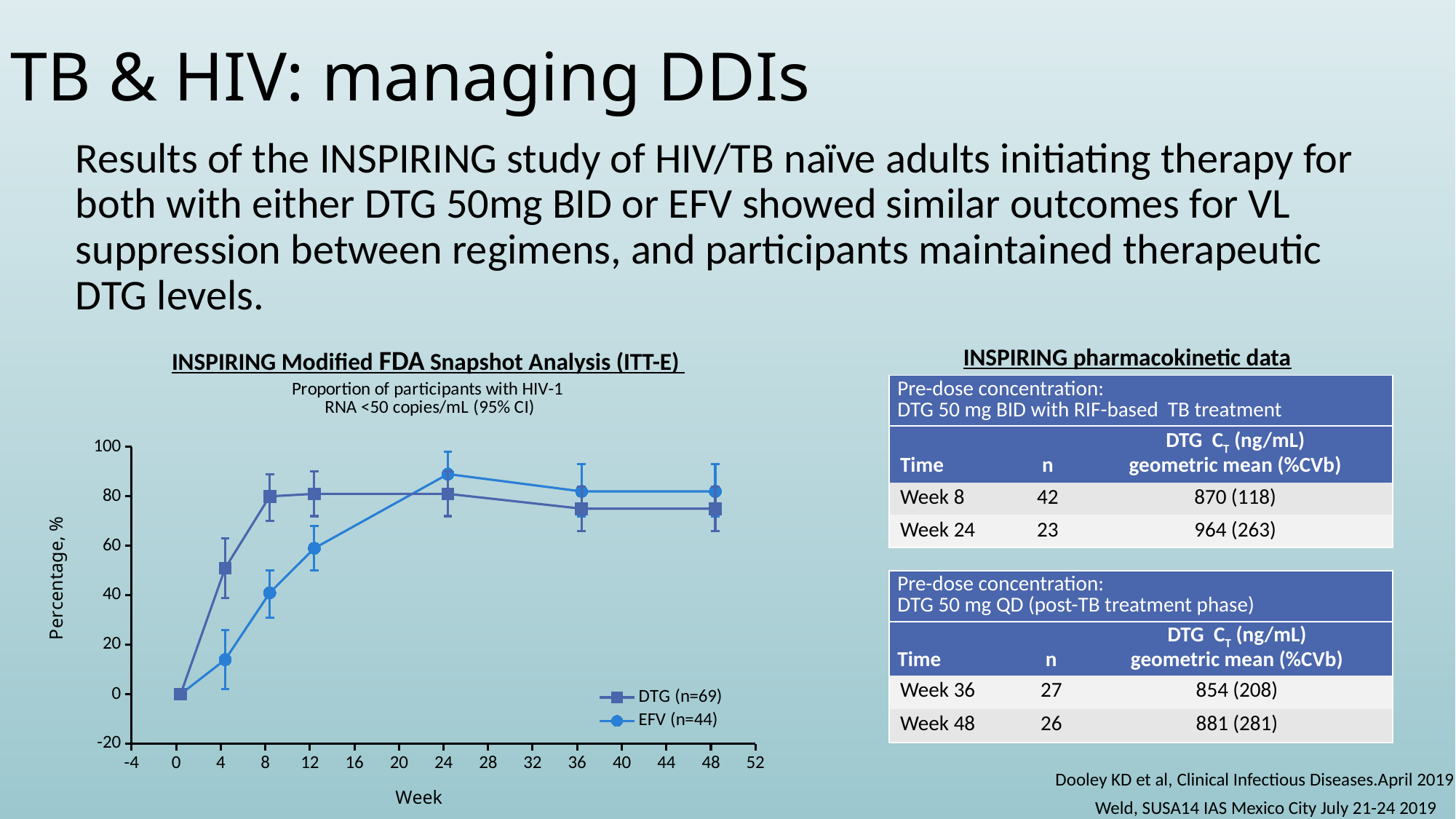
At which week does the EFV (n=44) series reach its highest value? Week 24 Which series has the larger value at week 12, DTG (n=69) or EFV (n=44)? DTG (n=69) What kind of chart is shown on the slide? line chart What are the two series named in the chart legend? DTG (n=69) and EFV (n=44) What is the title of the chart? Proportion of participants with HIV-1 RNA <50 copies/mL (95% CI) Is the value for DTG (n=69) at week 4 greater or less than 40? greater How many series does the chart legend list? 2 What is the value for DTG (n=69) at week 0? 0 How many time points are plotted for the EFV (n=44) series? 7 Is the value for EFV (n=44) at week 8 greater or less than 60? less Is the value for EFV (n=44) at week 4 greater or less than 20? less Which series has the larger value at week 24, DTG (n=69) or EFV (n=44)? EFV (n=44)